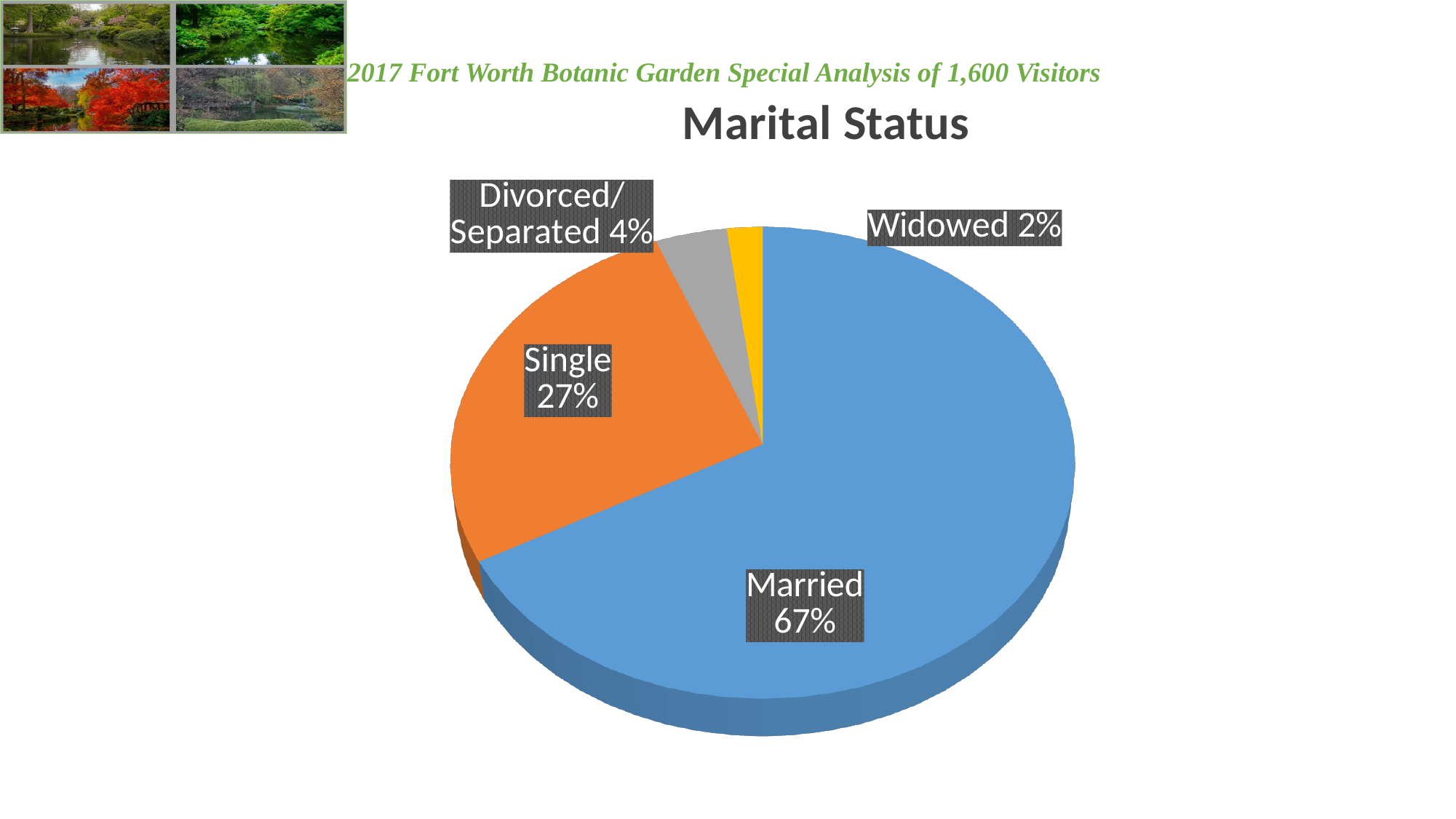
What share of visitors are Married? 67% Which marital status category has the largest share? Married What is the difference in percentage points between the Married and Single shares? 40 How many categories does the pie chart show? 4 What is the title of the chart? Marital Status Which is larger, the Single share or the Divorced/Separated share? Single What kind of chart is shown on the slide? Pie chart Which marital status category has the smallest share? Widowed What share of visitors are Widowed? 2% What share of visitors are Divorced/Separated? 4% What share of visitors are Single? 27% What is the difference in percentage points between the Divorced/Separated and Widowed shares? 2